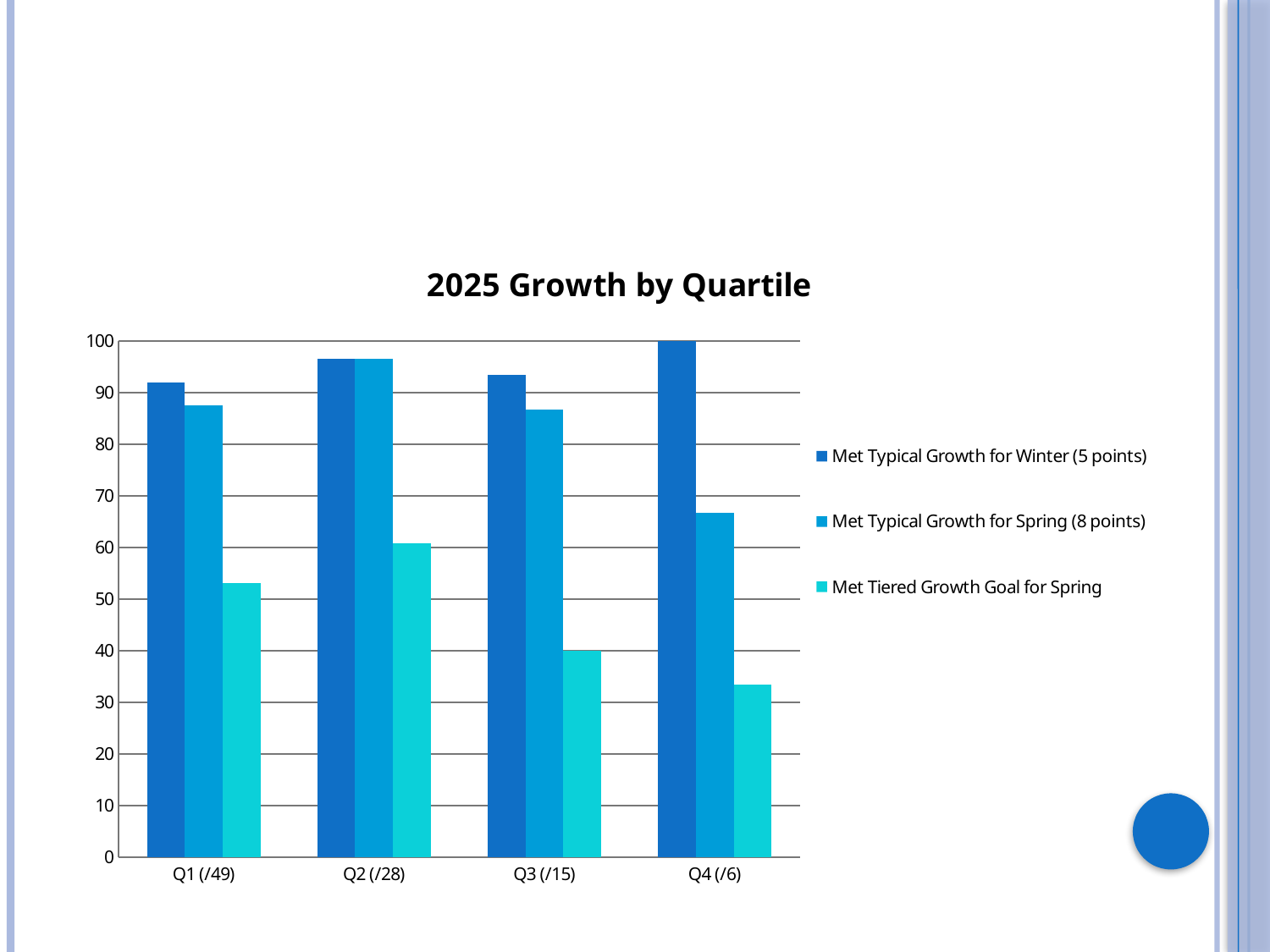
What is the value for Met Tiered Growth Goal for Spring in Q3 (/15)? 40 Is the value for Met Typical Growth for Spring (8 points) in Q4 (/6) greater or less than 70? less Which quartile has the highest value for Met Typical Growth for Winter (5 points)? Q4 (/6) How many quartile categories are shown on the x axis? 4 In Q2 (/28), which is larger: Met Typical Growth for Winter (5 points) or Met Tiered Growth Goal for Spring? Met Typical Growth for Winter (5 points) Which quartile has the lowest value for Met Typical Growth for Spring (8 points)? Q4 (/6) What is the title of the chart? 2025 Growth by Quartile What is the value for Met Typical Growth for Winter (5 points) in Q4 (/6)? 100 Which quartile has the lowest value for Met Tiered Growth Goal for Spring? Q4 (/6) How many series does the legend list? 3 What kind of chart is shown on the slide? bar chart Is the value for Met Tiered Growth Goal for Spring in Q1 (/49) greater or less than 50? greater